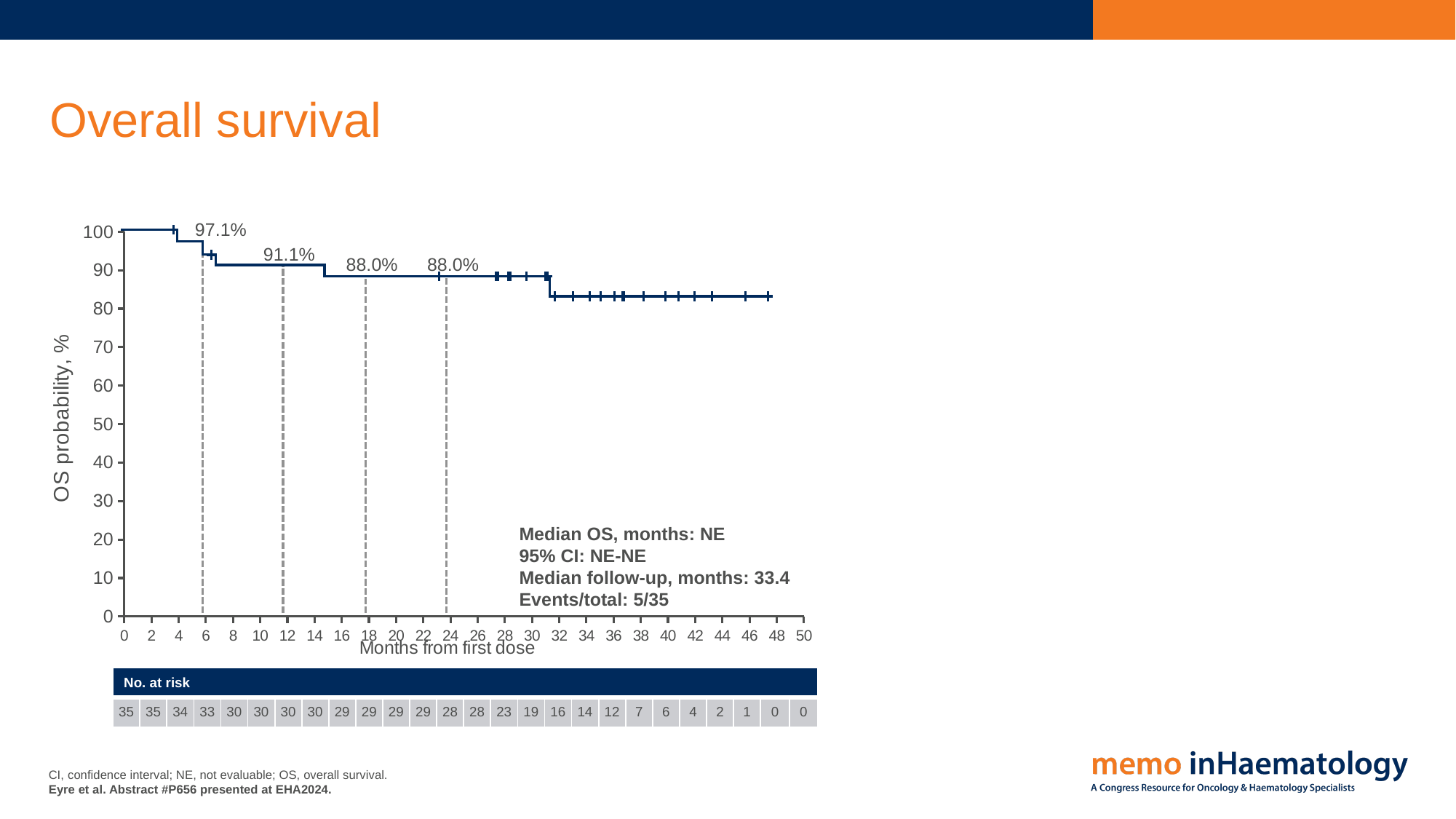
What OS probability is labelled at the dashed lines around 18 and 24 months? 88.0% What kind of chart is shown on the slide? Kaplan-Meier survival curve (step line chart) Is the OS probability at 40 months greater or less than 80%? greater How many patients are at risk at 24 months? 28 What is the first OS probability value labelled on the curve? 97.1% What is the difference between the first labelled value (97.1%) and the second labelled value (91.1%)? 6.0 percentage points What is the label of the y axis? OS probability, % What is the median follow-up in months stated on the chart? 33.4 How many patients are at risk at 36 months? 12 Does the OS probability rise or fall as months from first dose increase? Fall What OS probability is labelled at the second dashed line (around 12 months)? 91.1% How many patients are at risk at month 0? 35